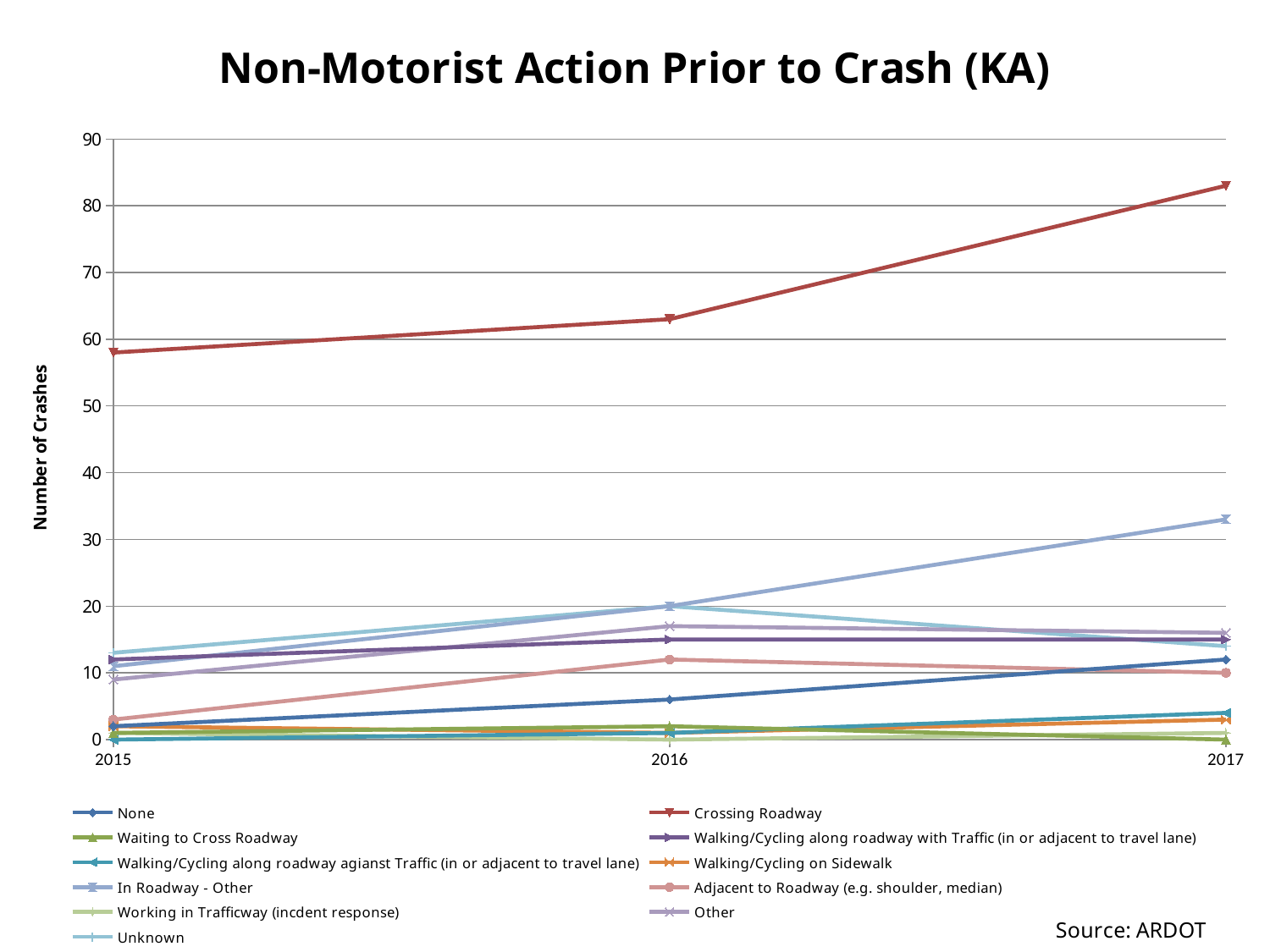
Does the number of crashes for Crossing Roadway rise or fall from 2015 to 2017? rise How many series does the legend list? 11 Is the value for In Roadway - Other in 2017 greater or less than 30? greater What is the title of the chart? Non-Motorist Action Prior to Crash (KA) Which is larger in 2017, Crossing Roadway or In Roadway - Other? Crossing Roadway Is the value for Crossing Roadway in 2017 greater or less than 80? greater Is the value for None in 2016 greater or less than 10? less How many years are plotted along the x axis? 3 Which series has the highest number of crashes in 2017? Crossing Roadway What is the label of the y axis? Number of Crashes What kind of chart is shown on the slide? line chart